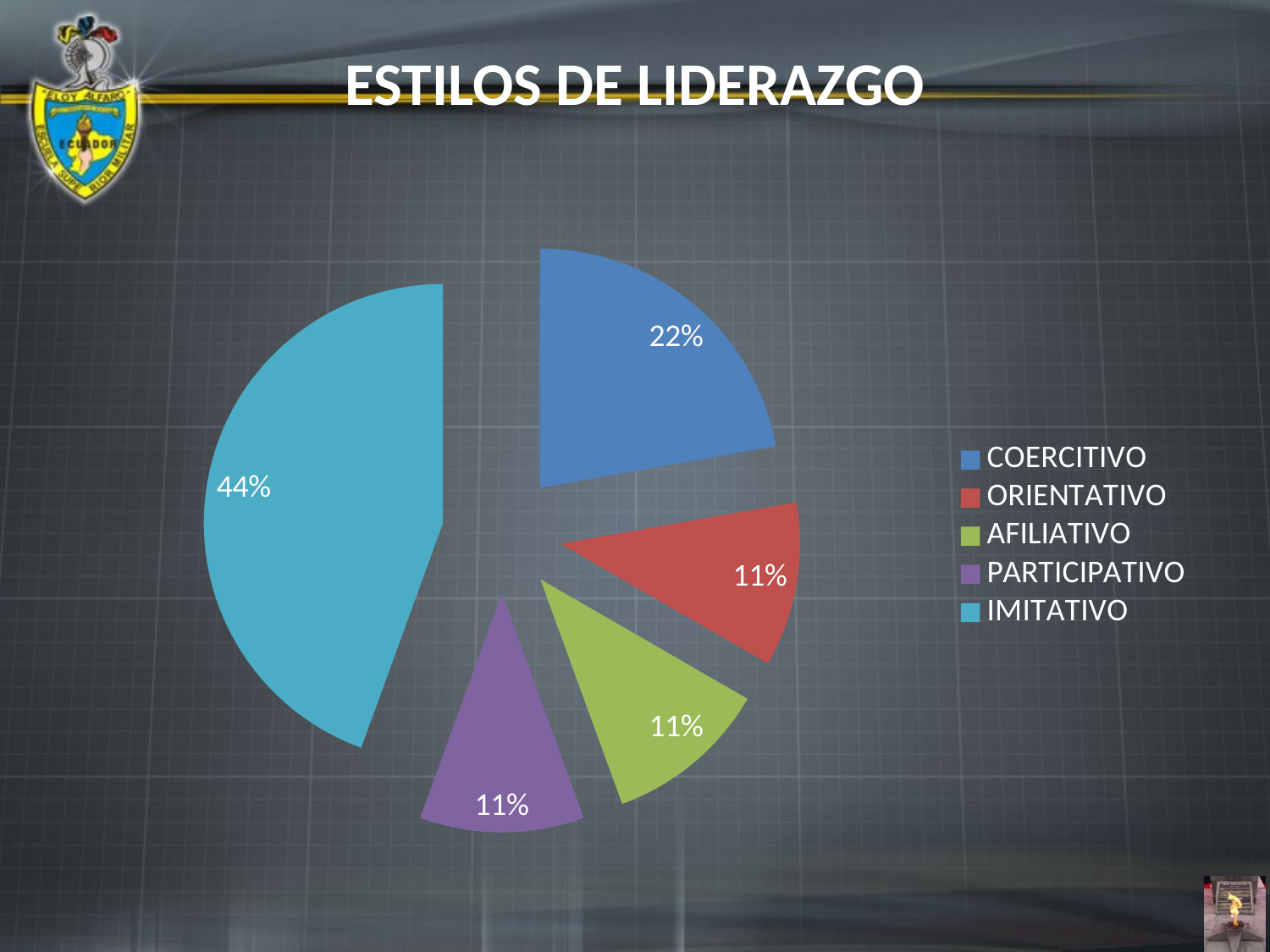
Which category has the largest share of the pie? IMITATIVO What percentage is shown for COERCITIVO? 22% What percentage is shown for IMITATIVO? 44% What percentage is shown for ORIENTATIVO? 11% What kind of chart is shown on the slide? pie chart Which is larger, the share for COERCITIVO or the share for AFILIATIVO? COERCITIVO What is the title of the chart? ESTILOS DE LIDERAZGO What percentage is shown for PARTICIPATIVO? 11% What colour is the IMITATIVO slice? light blue (cyan) How many slices are labelled 11%? 3 What is the difference between the shares of IMITATIVO and COERCITIVO? 22% How many categories does the legend list? 5